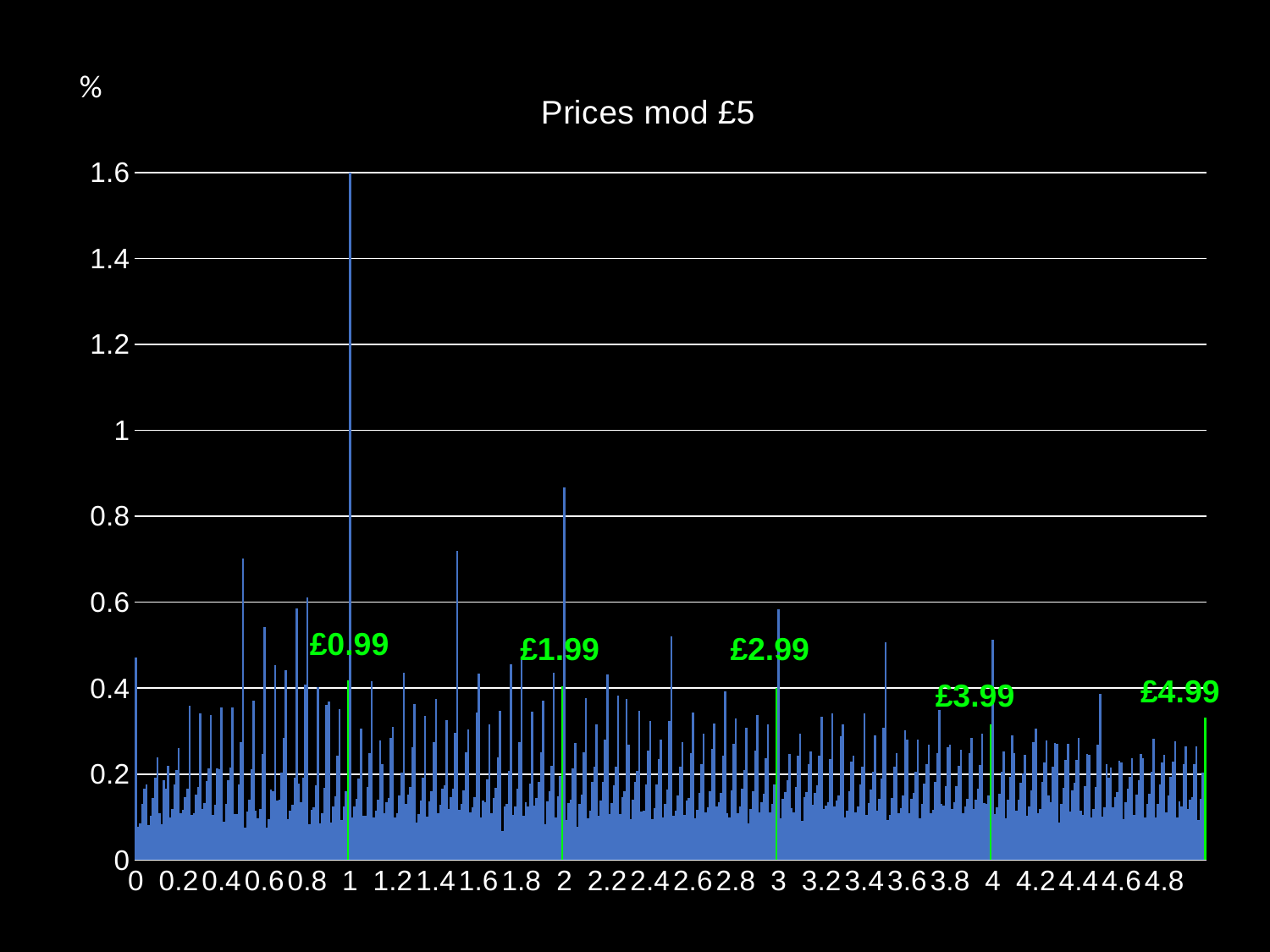
Which price has the tallest bar in the chart? £0.99 Is the value for £2.99 greater or less than 0.8? less What value does the bar at £0.99 reach on the y axis? 1.6 How many prices are labelled in green on the chart? 5 What is the title of the chart? Prices mod £5 What kind of chart is shown on the slide? bar chart Is the value for £0.99 greater or less than 1.4? greater Is the value for £1.99 greater or less than 1? less What unit is shown on the y axis of the chart? % Which has the larger value, £0.99 or £1.99? £0.99